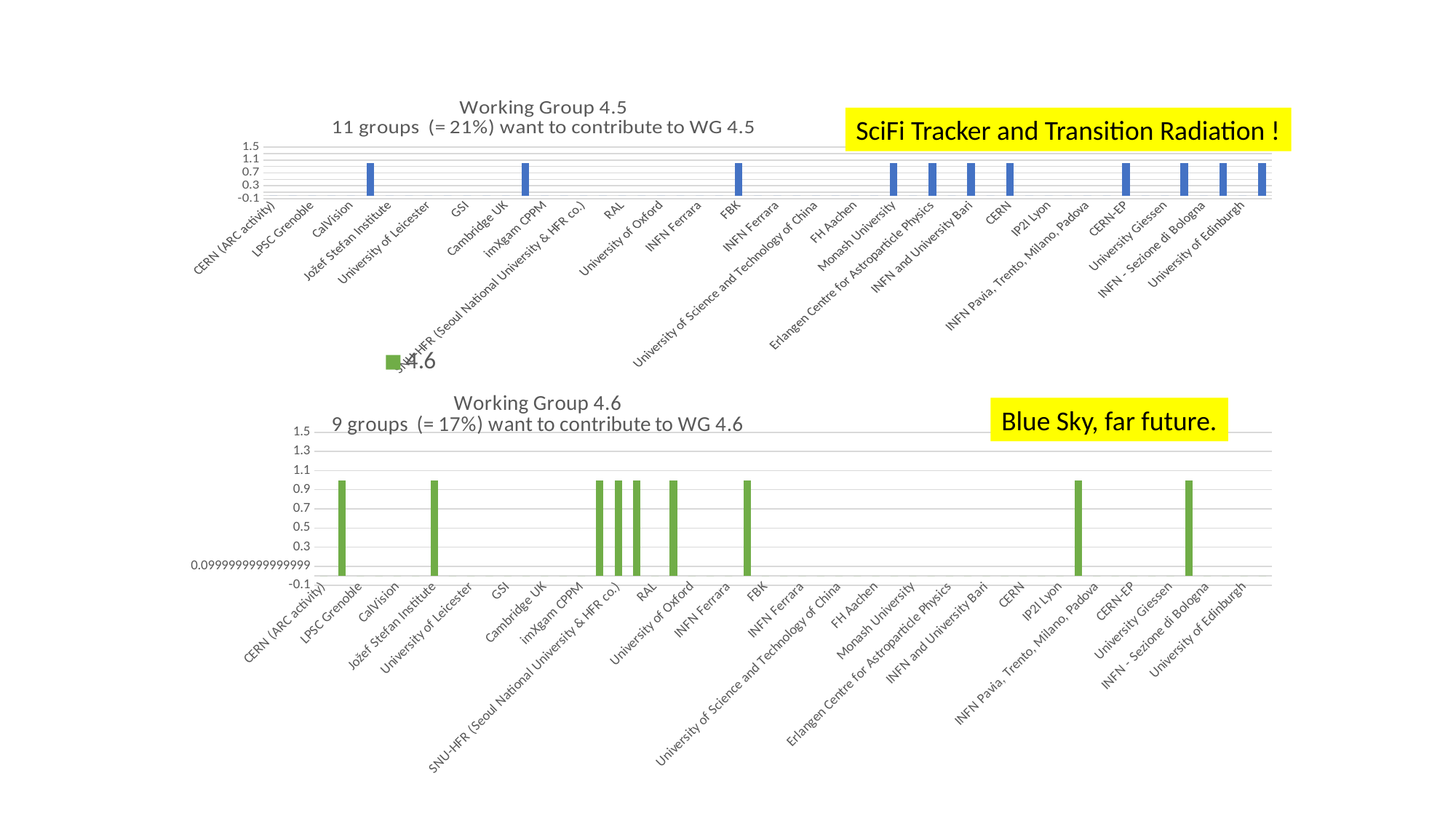
In the top chart (Working Group 4.5), how many categories are listed on the x axis? 26 What kind of chart is the top chart, Working Group 4.5? bar chart In the top chart (Working Group 4.5), is the value for University of Edinburgh greater or less than 1.1? less In the bottom chart (Working Group 4.6), is the value for RAL greater or less than 1.3? less What entry does the legend of the bottom chart show? 4.6 In the bottom chart (Working Group 4.6), how many categories are listed on the x axis? 26 In the top chart (Working Group 4.5), is the value for CalVision greater or less than 0.7? less What kind of chart is the bottom chart, Working Group 4.6? bar chart According to the subtitle of the top chart, how many groups want to contribute to WG 4.5? 11 groups (= 21%)